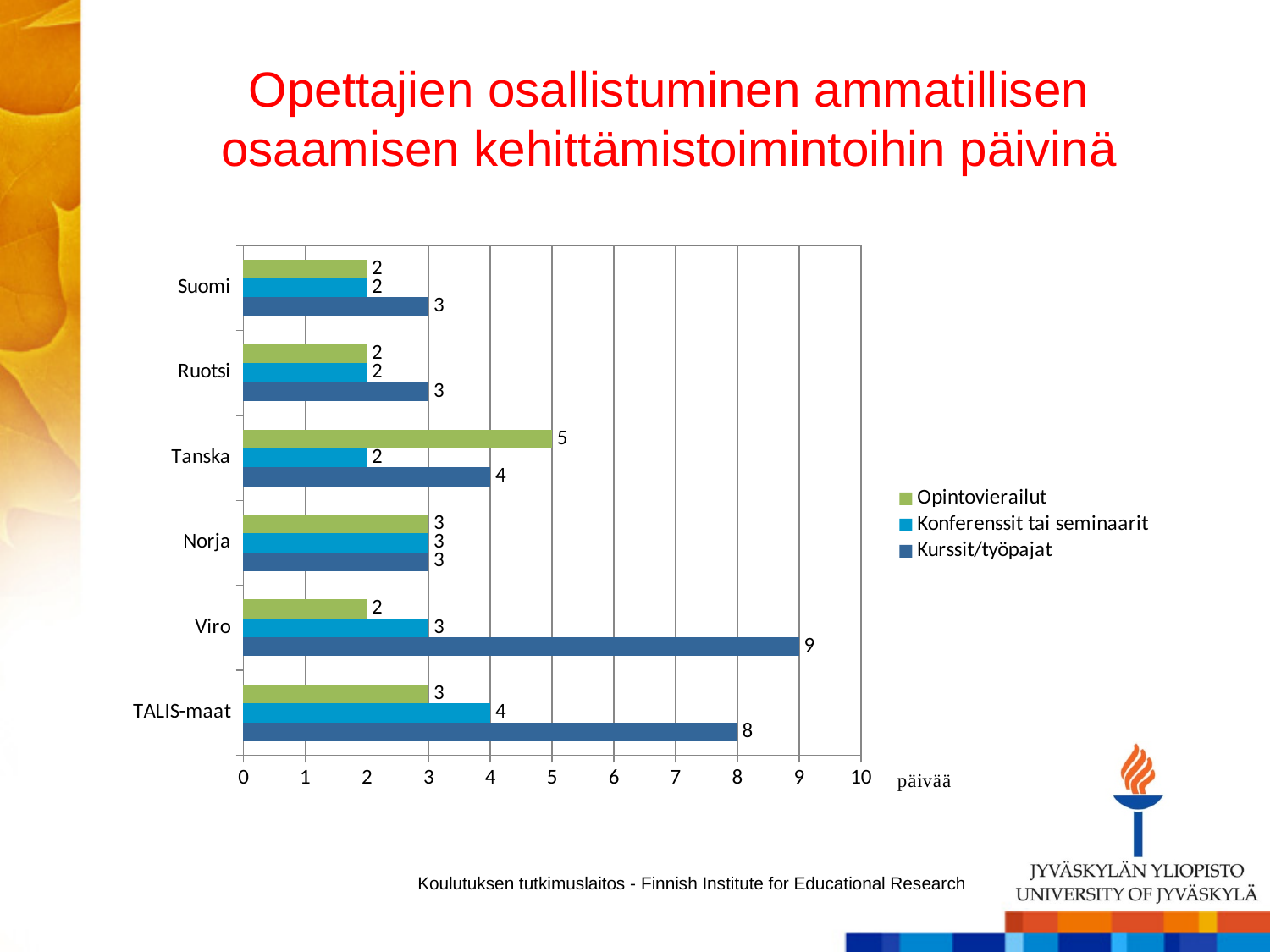
What unit label is shown at the end of the x axis? päivää What is the difference between the Kurssit/työpajat values for Viro and Suomi? 6 Which is larger for Tanska: Opintovierailut or Kurssit/työpajat? Opintovierailut How many countries/categories are shown on the chart? 6 What is the difference between the Kurssit/työpajat values for Viro and TALIS-maat? 1 What is the value of Kurssit/työpajat for Viro? 9 Which category has the highest value for Kurssit/työpajat? Viro What is the value of Konferenssit tai seminaarit for TALIS-maat? 4 How many series does the legend list? 3 What kind of chart is shown on the slide? bar chart Which category has the highest value for Opintovierailut? Tanska What is the value of Opintovierailut for Tanska? 5